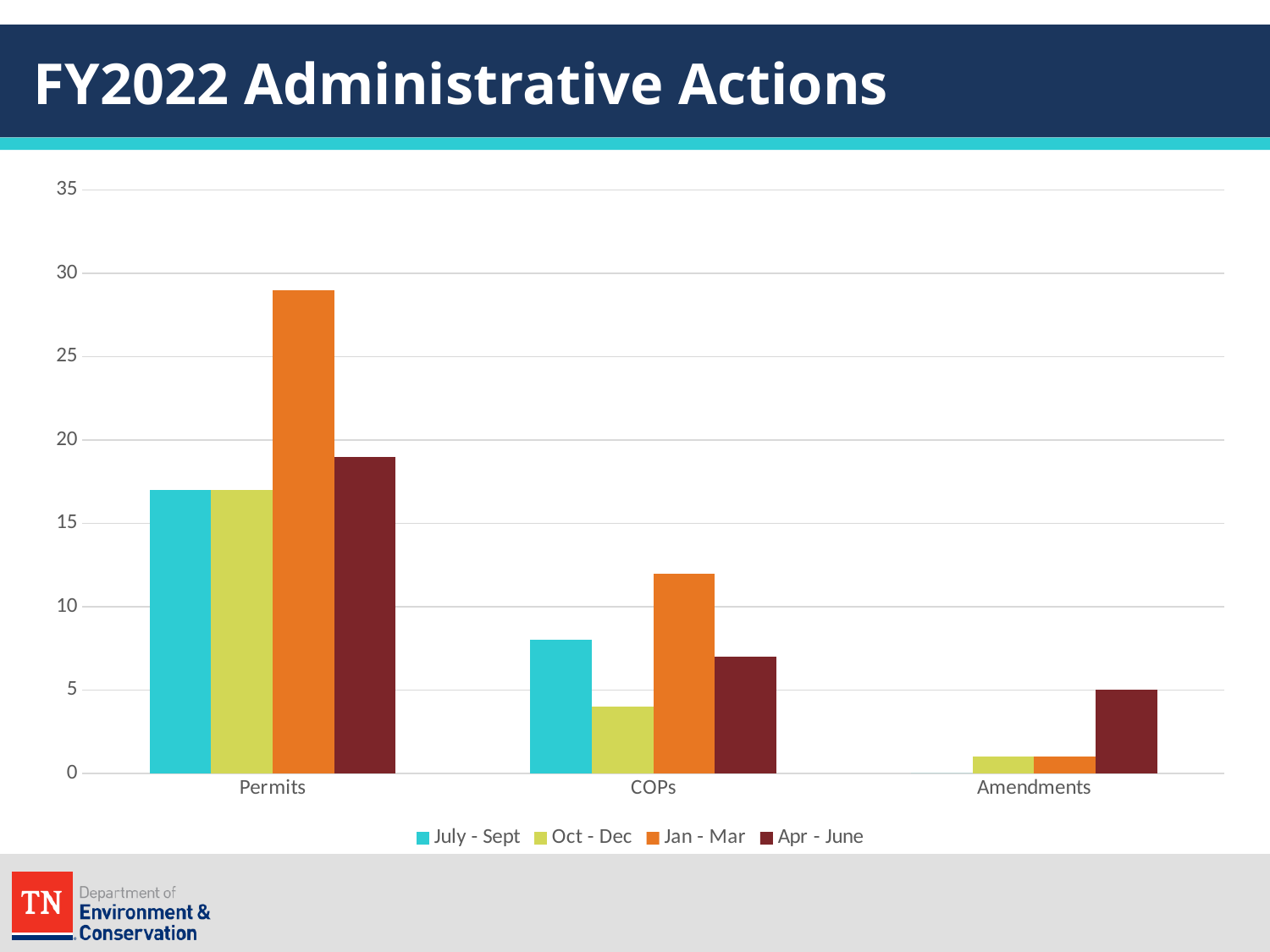
What kind of chart is shown on the slide? bar chart How many series does the legend list? 4 Which quarter has the lowest value for COPs? Oct - Dec Which quarter has the highest value for Permits? Jan - Mar Which category has the highest Jan - Mar value? Permits What is the title of the slide containing the chart? FY2022 Administrative Actions Is the Jan - Mar value for Permits greater or less than 25? greater Is the Oct - Dec value for COPs greater or less than 5? less Which is larger for COPs, the July - Sept value or the Apr - June value? July - Sept How many categories are shown on the x axis? 3 Is the Jan - Mar value for COPs greater or less than 10? greater Which quarter has the highest value for Amendments? Apr - June